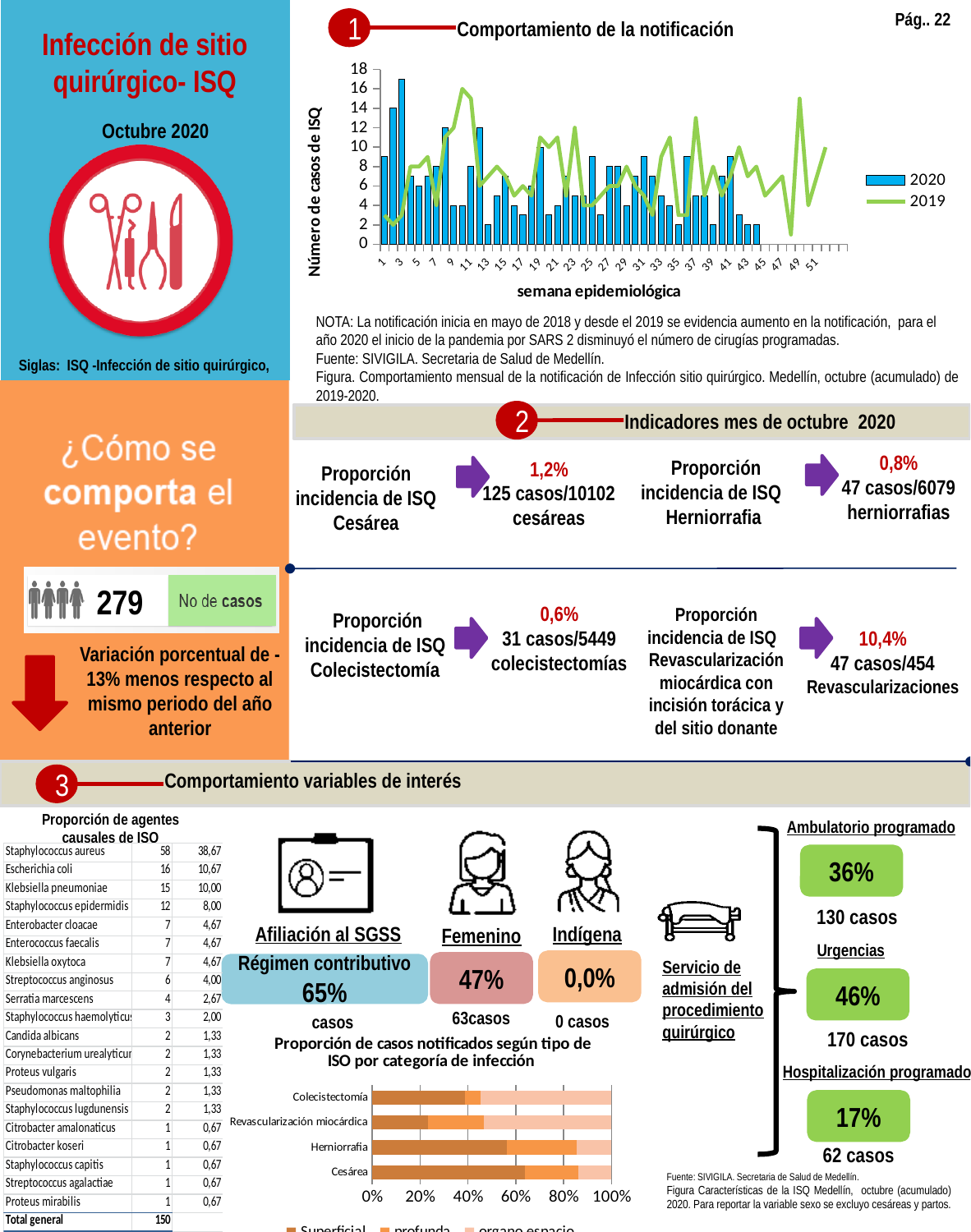
In the 'Comportamiento de la notificación' chart, which series is drawn as bars rather than a line? 2020 In the 'Comportamiento de la notificación' chart, how many series does the legend list? 2 In the 'Comportamiento de la notificación' chart, which epidemiological week has the tallest 2020 bar? 3 In the 'Proporción de casos notificados según tipo de ISO por categoría de infección' chart, which category has the largest 'Superficial' share? Cesárea In the 'Proporción de casos notificados según tipo de ISO por categoría de infección' chart, is the 'Superficial' share for Revascularización miocárdica greater or less than 40%? less In the 'Comportamiento de la notificación' chart, is the 2020 value for week 3 greater or less than 14? greater In the 'Comportamiento de la notificación' chart, what is the label of the x axis? semana epidemiológica In the 'Comportamiento de la notificación' chart, is the 2020 value for week 2 greater or less than 12? greater How many categories are shown in the 'Proporción de casos notificados según tipo de ISO por categoría de infección' chart? 4 What kind of chart is 'Proporción de casos notificados según tipo de ISO por categoría de infección'? stacked bar chart In the 'Proporción de casos notificados según tipo de ISO por categoría de infección' chart, which category has the smallest 'Superficial' share? Revascularización miocárdica